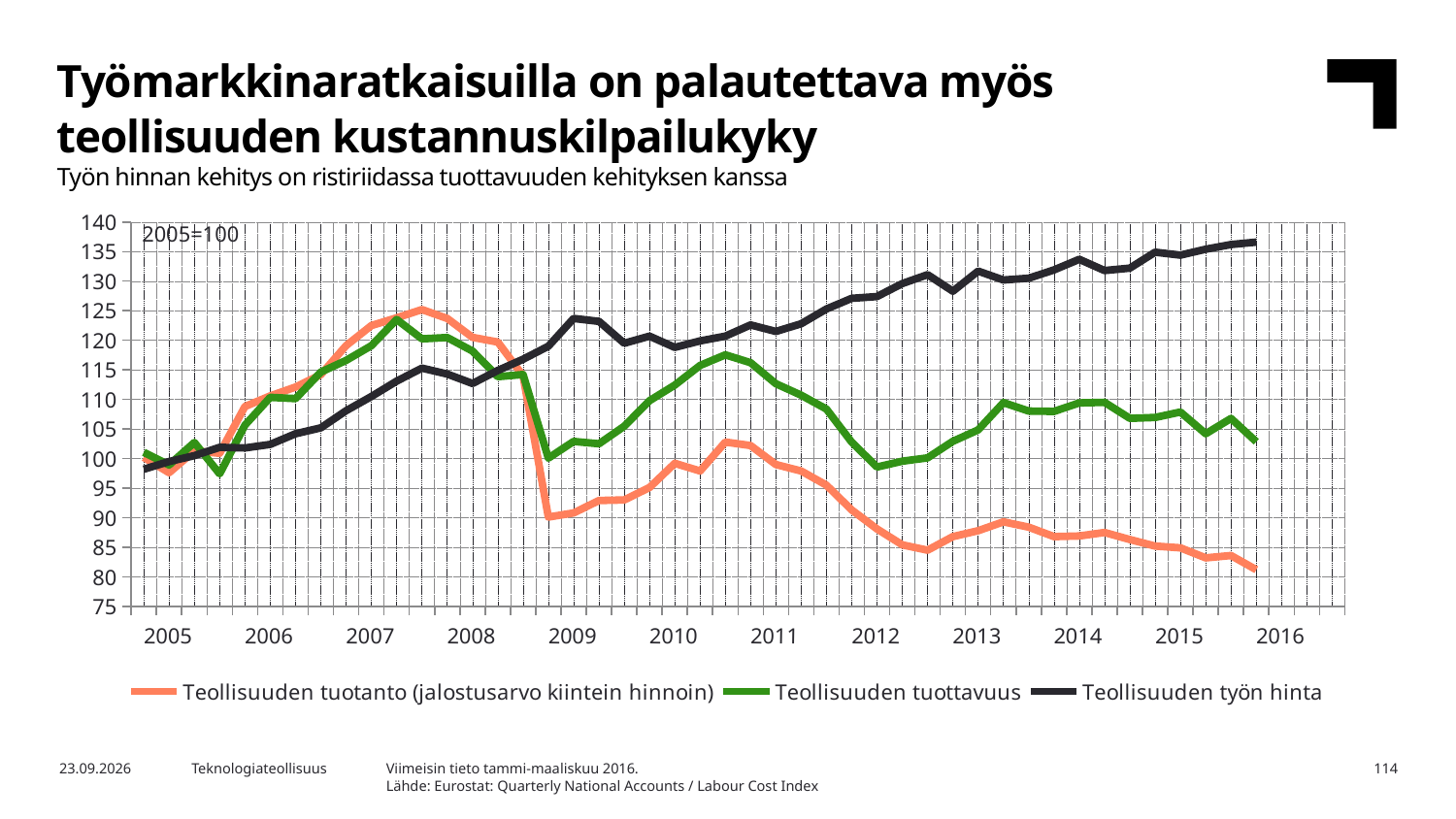
Is the value for Teollisuuden tuotanto at the end of the series (2016) greater or less than 85? less How many series does the legend list? 3 Is the value for Teollisuuden työn hinta at the end of the series (2016) greater or less than 130? greater How many year labels are shown on the x axis? 12 Is the value for Teollisuuden tuottavuus at the end of the series (2016) greater or less than 100? greater Which series has the lowest value at the end of the series (2016)? Teollisuuden tuotanto (jalostusarvo kiintein hinnoin) At the end of the series (2016), which is larger: Teollisuuden tuottavuus or Teollisuuden tuotanto? Teollisuuden tuottavuus Which series has the highest value at the end of the series (2016)? Teollisuuden työn hinta What base-year note is printed inside the chart area? 2005=100 Does Teollisuuden työn hinta rise or fall overall from 2005 to 2016? rise What kind of chart is shown on the slide? line chart